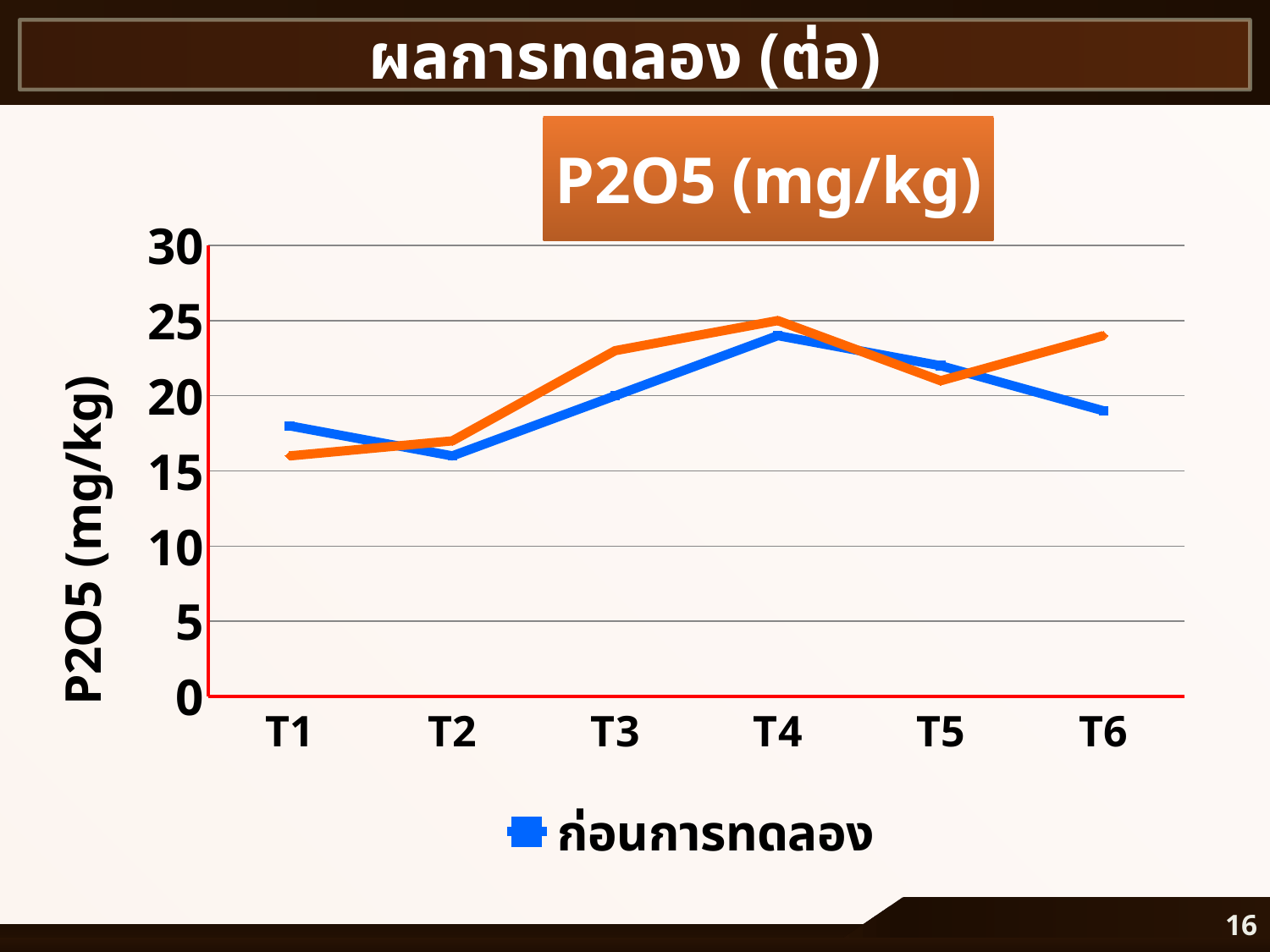
At which category does the ก่อนการทดลอง line reach its lowest value? T2 Does the ก่อนการทดลอง line rise or fall from T4 to T6? fall At T1, which line is higher, the blue line or the orange line? the blue line Is the value of ก่อนการทดลอง at T4 greater or less than 20? greater How many series does the legend list? 1 Is the value of ก่อนการทดลอง at T2 greater or less than 20? less What is the title of the chart? P2O5 (mg/kg) What kind of chart is shown on the slide? line chart Is the value of ก่อนการทดลอง at T1 greater or less than 20? less How many categories are shown on the x axis of the chart? 6 At which category does the ก่อนการทดลอง line reach its highest value? T4 What is the legend entry shown for the blue line? ก่อนการทดลอง